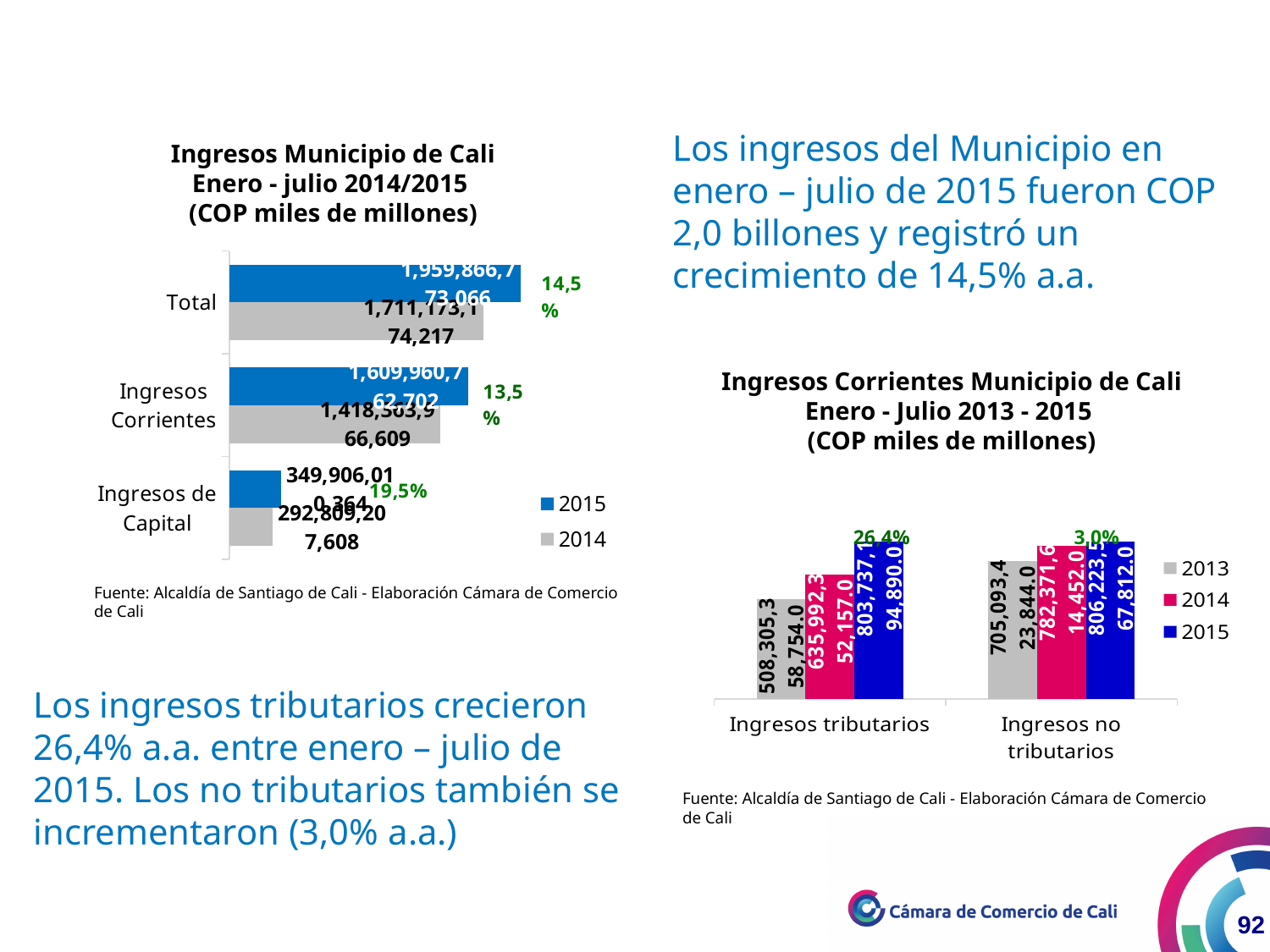
In the left chart 'Ingresos Municipio de Cali', what growth percentage is printed next to the Ingresos de Capital bars? 19,5% In the left chart 'Ingresos Municipio de Cali', what growth percentage is printed next to the Total bars? 14,5% In the left chart 'Ingresos Municipio de Cali', how many categories are shown on the vertical axis? 3 In the right chart 'Ingresos Corrientes Municipio de Cali', which year has the tallest bar for Ingresos tributarios? 2015 In the left chart 'Ingresos Municipio de Cali', how many series does the legend list? 2 In the left chart 'Ingresos Municipio de Cali', which category has the longest bars? Total In the left chart 'Ingresos Municipio de Cali', which category has the shortest bars? Ingresos de Capital In the left chart 'Ingresos Municipio de Cali', which is larger for 2015: Ingresos Corrientes or Ingresos de Capital? Ingresos Corrientes In the right chart 'Ingresos Corrientes Municipio de Cali', which colour represents 2014 in the legend? Pink/magenta What kind of chart is the left chart titled 'Ingresos Municipio de Cali Enero - julio 2014/2015'? Bar chart In the right chart 'Ingresos Corrientes Municipio de Cali', how many series does the legend list? 3 In the right chart 'Ingresos Corrientes Municipio de Cali', what growth percentage is printed above the Ingresos tributarios bars? 26,4%